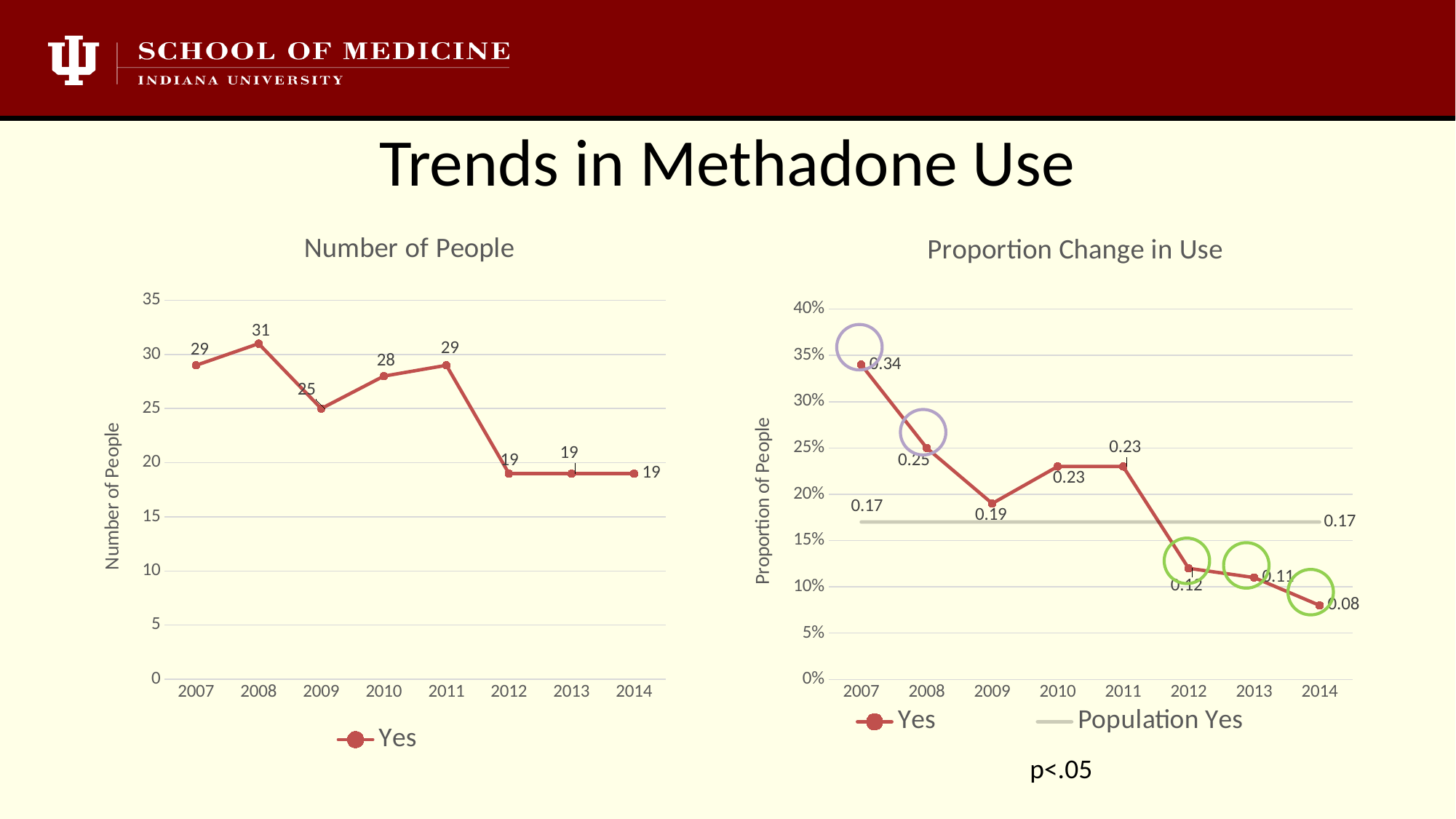
In the 'Proportion Change in Use' chart, what is the Yes value for 2007? 0.34 In the 'Proportion Change in Use' chart, which year has the lowest Yes value? 2014 What is the y-axis label of the 'Proportion Change in Use' chart? Proportion of People In the 'Number of People' chart, how many years are plotted on the x axis? 8 In the 'Number of People' chart, what is the value for 2008? 31 In the 'Number of People' chart, which year has the highest value? 2008 In the 'Number of People' chart, what is the difference between the values for 2011 and 2012? 10 In the 'Proportion Change in Use' chart, is the Yes value for 2009 larger or smaller than the Yes value for 2010? smaller In the 'Proportion Change in Use' chart, do the Yes values generally rise or fall from 2007 to 2014? fall In the 'Proportion Change in Use' chart, how many series does the legend list? 2 In the 'Proportion Change in Use' chart, what is the value of the Population Yes line? 0.17 In the 'Number of People' chart, what type of chart is shown? line chart